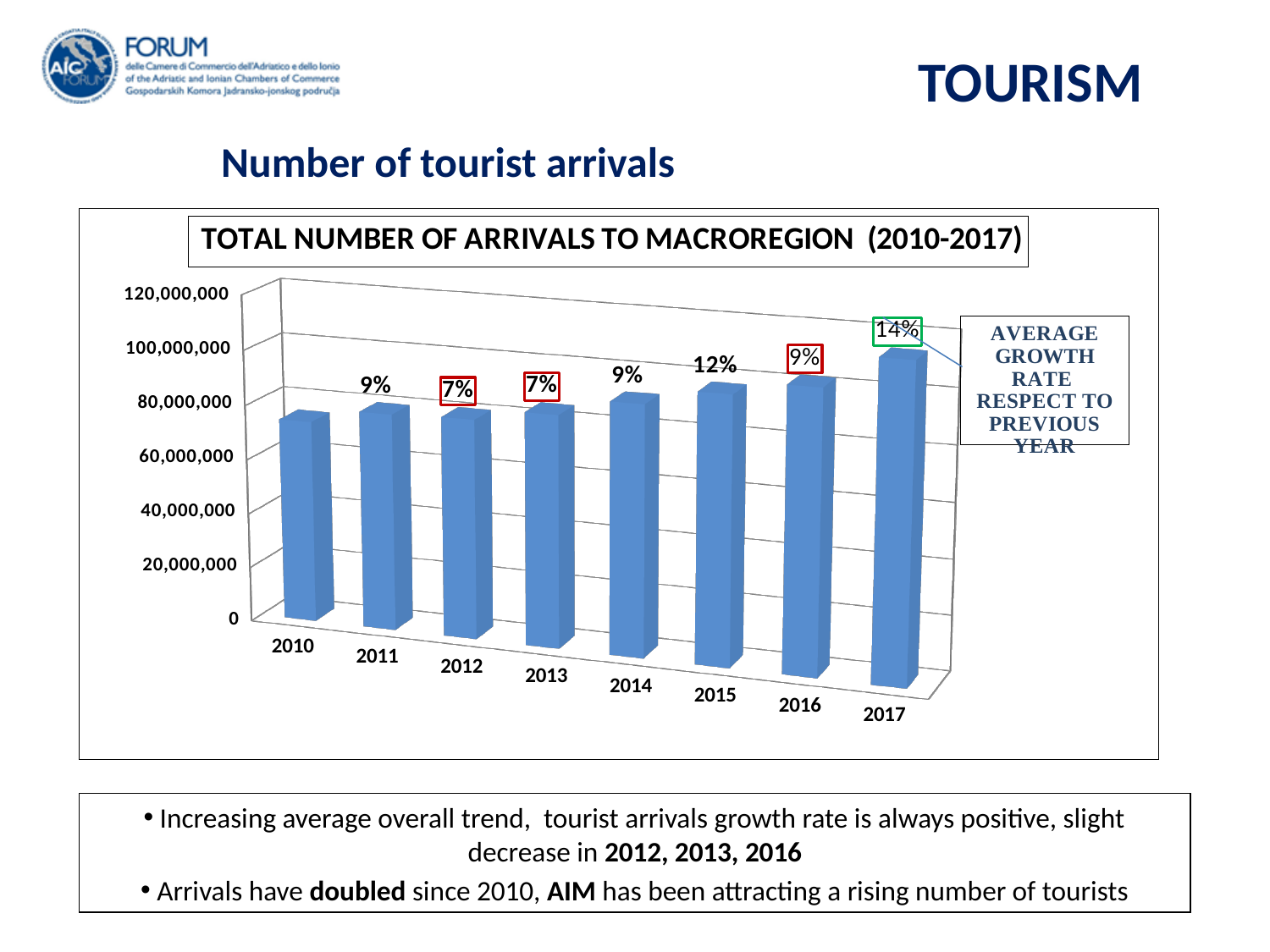
How many years (bars) are plotted in the chart? 8 Is the value for 2010 greater or less than 100,000,000? less What is the difference between the growth rate labelled for 2017 and the one labelled for 2015? 2% Do the number of arrivals generally rise or fall from 2010 to 2017? rise What growth rate is labelled above the bar for 2015? 12% Which year has the highest labelled growth rate? 2017 What growth rate is labelled above the bar for 2017? 14% What kind of chart is shown on the slide? bar chart Is the value for 2017 greater or less than 80,000,000? greater Which bar is taller, 2010 or 2017? 2017 What growth rate is labelled above the bar for 2012? 7% What is the title of the chart? TOTAL NUMBER OF ARRIVALS TO MACROREGION (2010-2017)